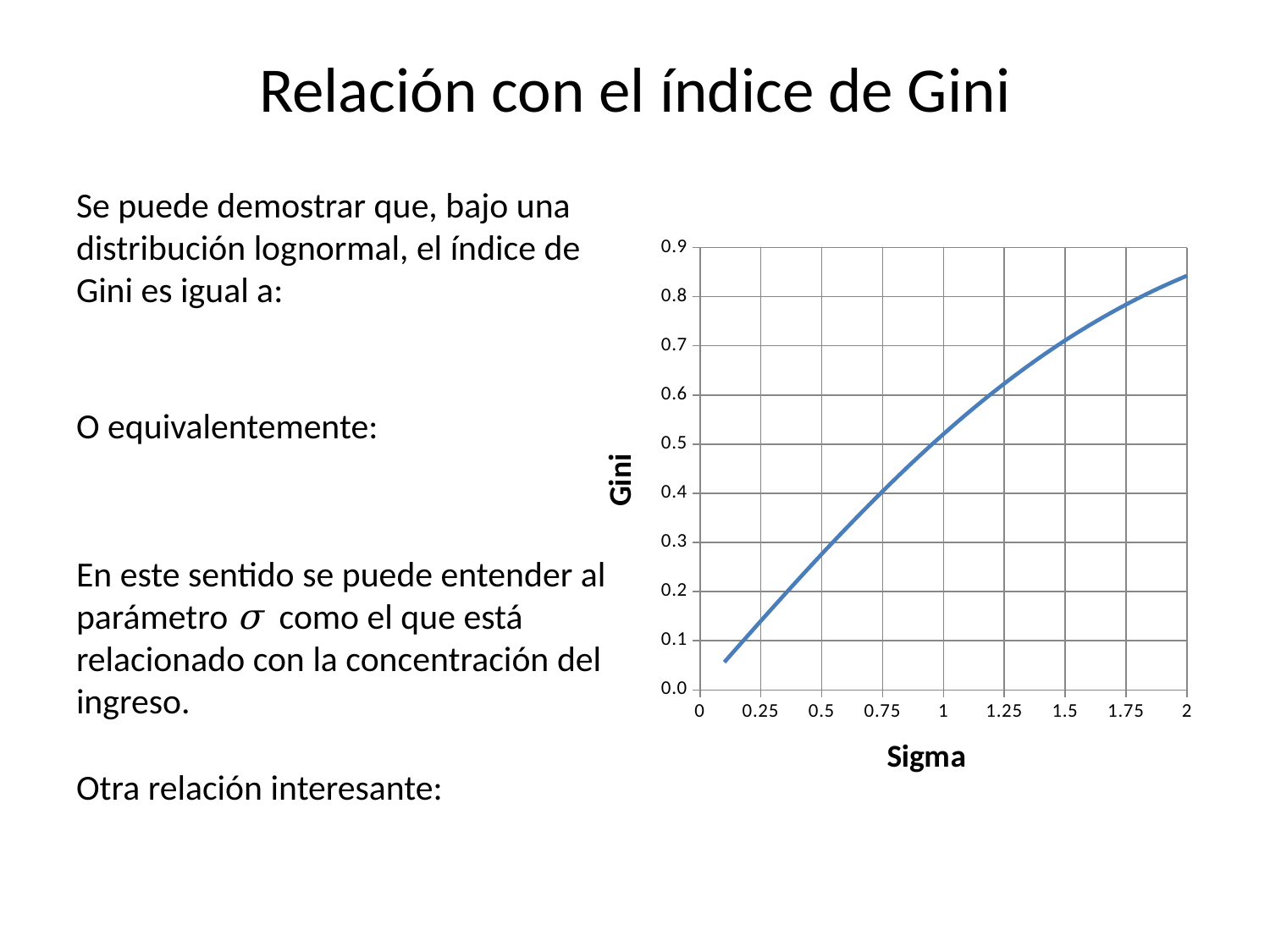
Does the Gini value rise or fall as Sigma increases along the x axis? rise Is the Gini value at Sigma = 2 greater or less than 0.8? greater Is the Gini value at Sigma = 0.25 greater or less than 0.1? greater Is the Gini value at Sigma = 1.75 greater or less than 0.8? less At which labelled Sigma value on the x axis does the curve reach its highest Gini value? 2 What is the title of the x axis of the chart? Sigma What is the title of the y axis of the chart? Gini Which is larger, the Gini value at Sigma = 0.5 or at Sigma = 1.5? Sigma = 1.5 What kind of chart is shown on the slide? line chart